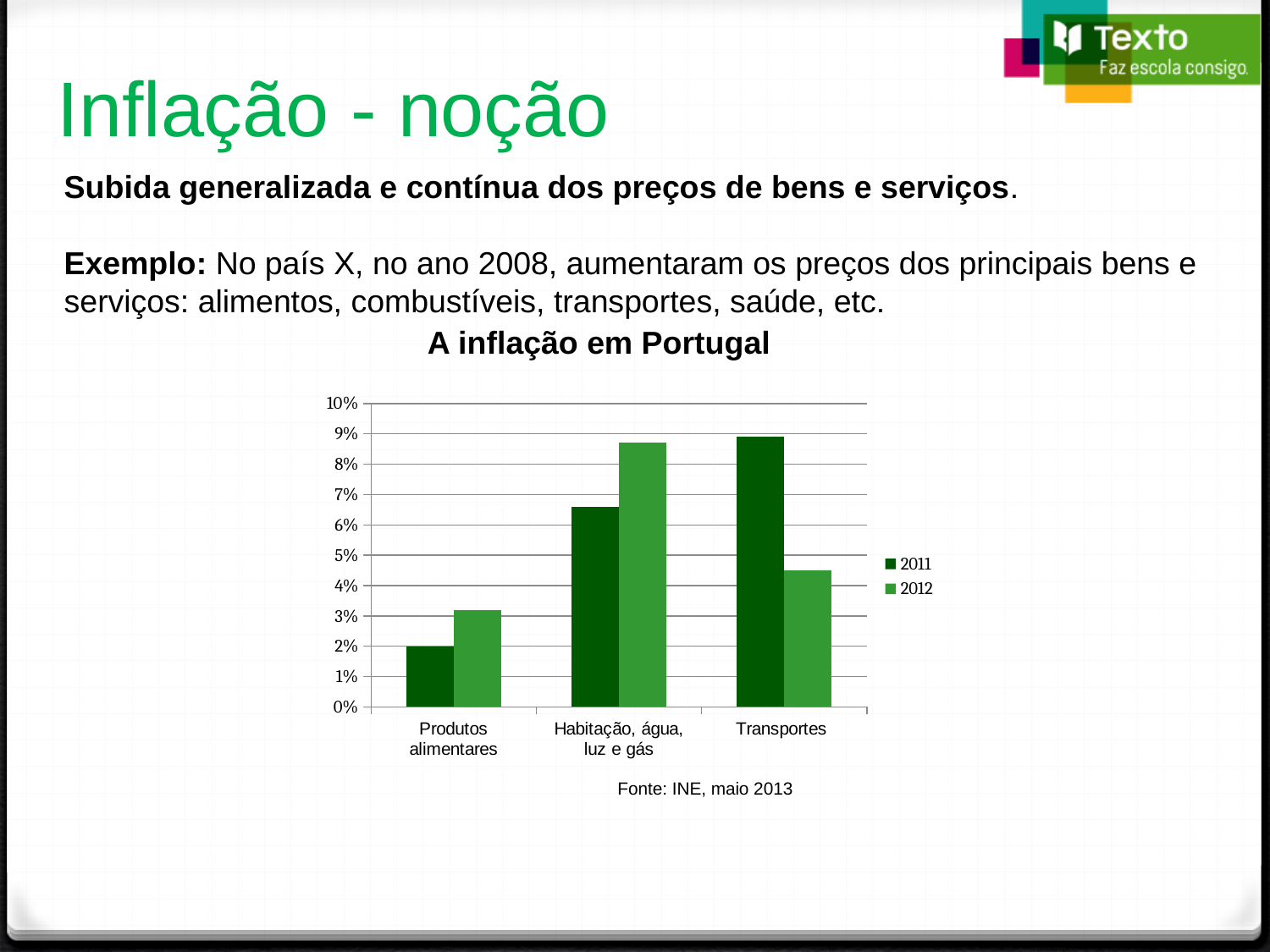
What kind of chart is shown on the slide? bar chart Is the 2012 value for Transportes greater or less than 5%? less Is the 2012 value for Habitação, água, luz e gás greater or less than 8%? greater Which category has the highest value for 2011? Transportes For Transportes, which year has the larger value, 2011 or 2012? 2011 How many categories are shown on the x axis of the chart? 3 What is the title of the chart? A inflação em Portugal How many series does the chart's legend list? 2 Which category has the lowest value for 2011? Produtos alimentares Which category has the lowest value for 2012? Produtos alimentares Which category has the highest value for 2012? Habitação, água, luz e gás For Habitação, água, luz e gás, which year has the larger value, 2011 or 2012? 2012